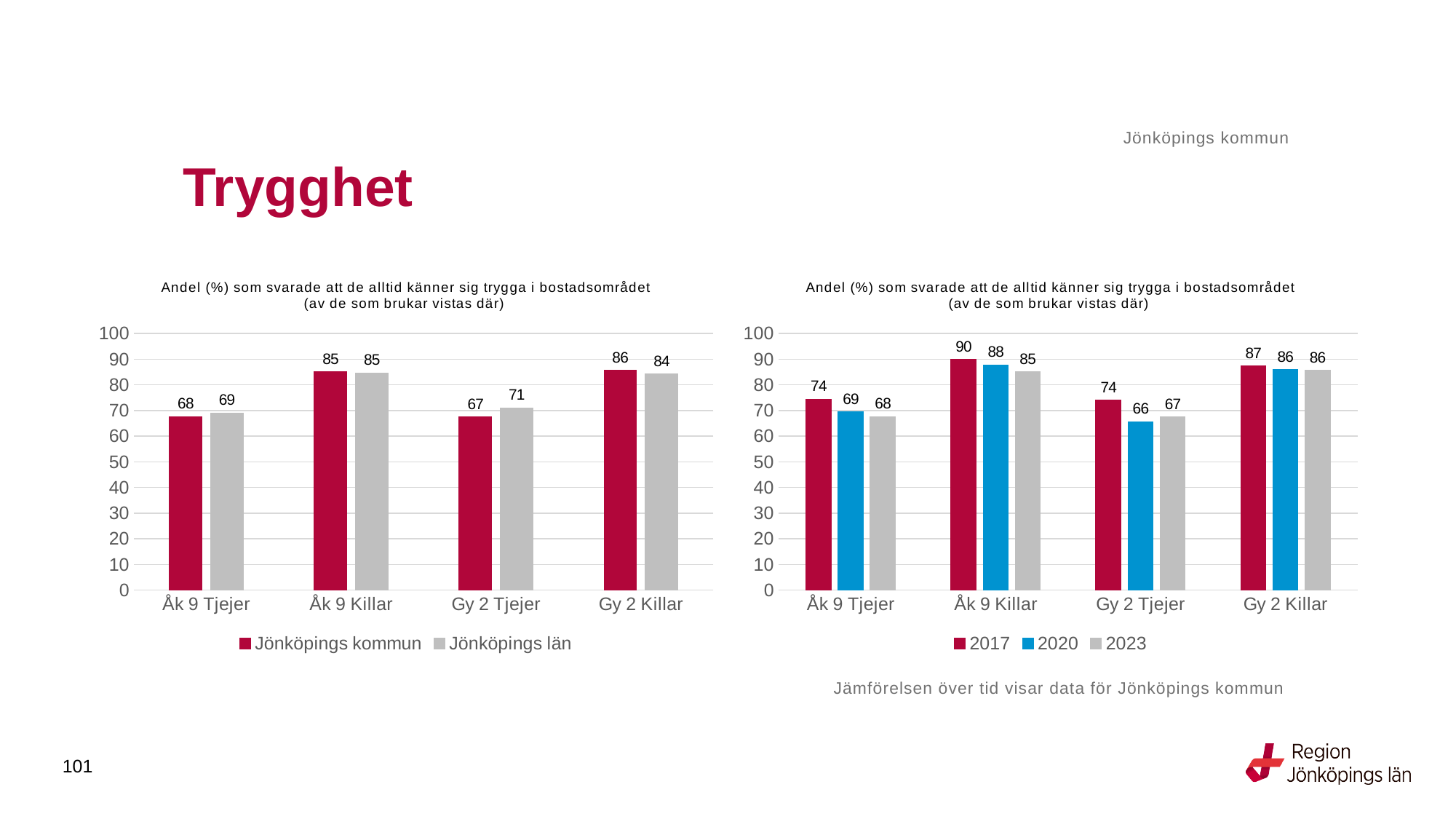
In the right chart, what is the value for 2020 for Gy 2 Tjejer? 66 In the left chart, how many series does the legend list? 2 In the right chart, what is the value for 2017 for Åk 9 Killar? 90 In the right chart, is the 2017 value for Gy 2 Killar larger than the 2020 value for Gy 2 Killar? Yes, 87 vs 86 In the right chart, how many categories are shown on the x axis? 4 In the left chart, what is the difference between Jönköpings län and Jönköpings kommun for Gy 2 Tjejer? 4 In the left chart, what is the value for Jönköpings län for Gy 2 Tjejer? 71 In the left chart, what is the value for Jönköpings kommun for Åk 9 Tjejer? 68 In the right chart, which category has the lowest value for 2023? Gy 2 Tjejer In the left chart, which category has the highest value for Jönköpings kommun? Gy 2 Killar In the right chart, what is the difference between the 2017 and 2023 values for Åk 9 Tjejer? 6 What kind of chart is the right chart? Bar chart